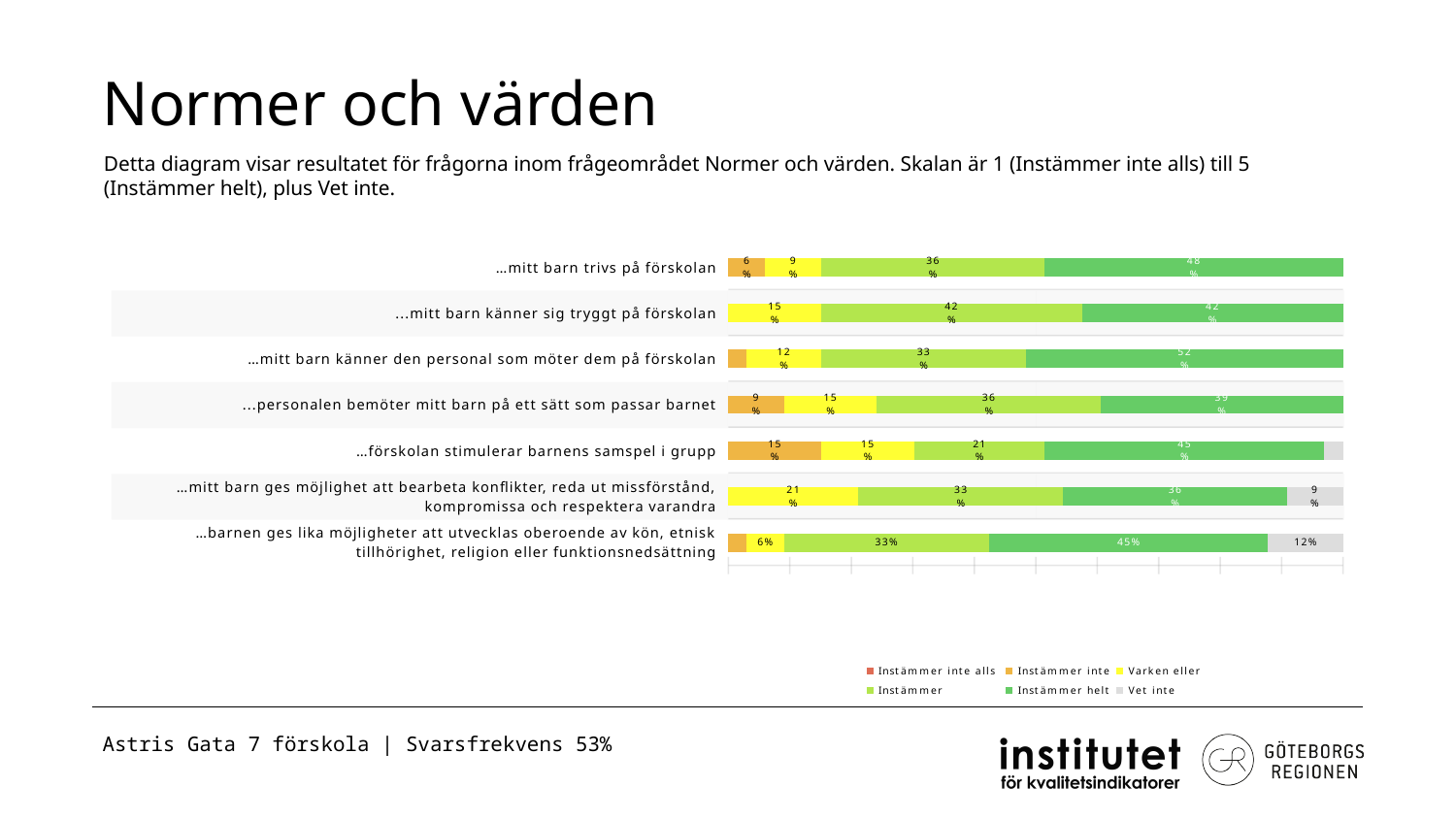
Which question has the highest 'Instämmer helt' value? …mitt barn känner den personal som möter dem på förskolan What is the 'Instämmer' value for '…mitt barn känner sig tryggt på förskolan'? 42% What is the title of the slide containing the chart? Normer och värden What is the 'Vet inte' value for '…barnen ges lika möjligheter att utvecklas oberoende av kön, etnisk tillhörighet, religion eller funktionsnedsättning'? 12% What kind of chart is shown on the slide? stacked bar chart How many questions (categories) are plotted in the chart? 7 How many series does the legend list? 6 What is the difference between the 'Instämmer helt' and 'Instämmer' values for '…mitt barn trivs på förskolan'? 12% What is the 'Instämmer helt' value for '…mitt barn känner den personal som möter dem på förskolan'? 52% Which is larger for '…personalen bemöter mitt barn på ett sätt som passar barnet': 'Instämmer' or 'Instämmer helt'? Instämmer helt What is the 'Varken eller' value for '…mitt barn ges möjlighet att bearbeta konflikter, reda ut missförstånd, kompromissa och respektera varandra'? 21% What is the 'Instämmer helt' value for '…mitt barn trivs på förskolan'? 48%